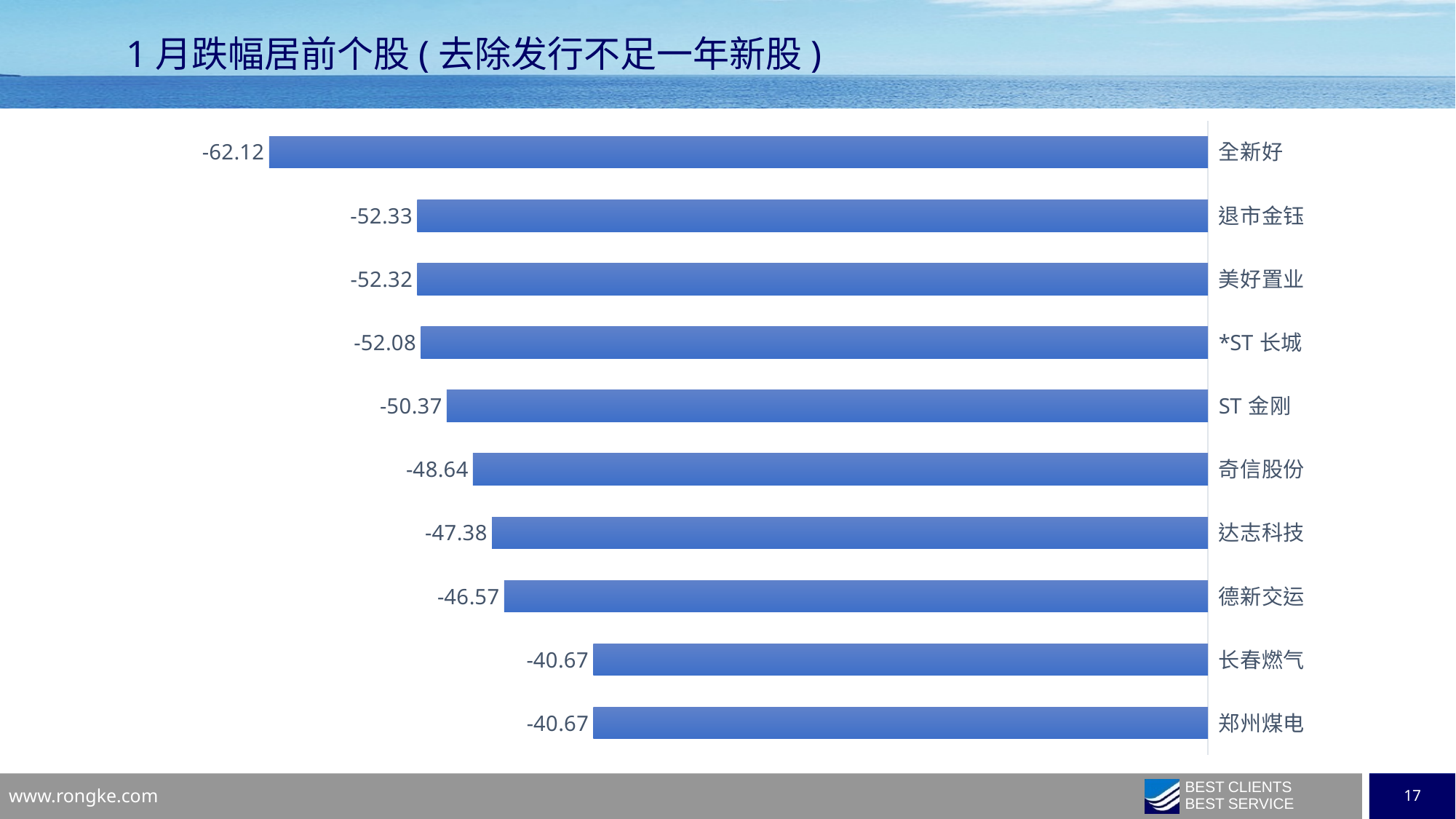
Which has the larger (less negative) value, *ST 长城 or 奇信股份? 奇信股份 Which stock has the lowest (most negative) value on the chart? 全新好 How many stocks are shown on the chart? 10 What is the title of the slide? 1 月跌幅居前个股 ( 去除发行不足一年新股 ) What kind of chart is shown on the slide? Bar chart What is the value shown for ST 金刚? -50.37 What is the difference between the values for 全新好 and 郑州煤电? 21.45 What is the value shown for 郑州煤电? -40.67 What is the difference between the values for 退市金钰 and 德新交运? 5.76 Which has the larger (less negative) value, 全新好 or 长春燃气? 长春燃气 What is the value shown for 达志科技? -47.38 What is the value shown for 全新好? -62.12